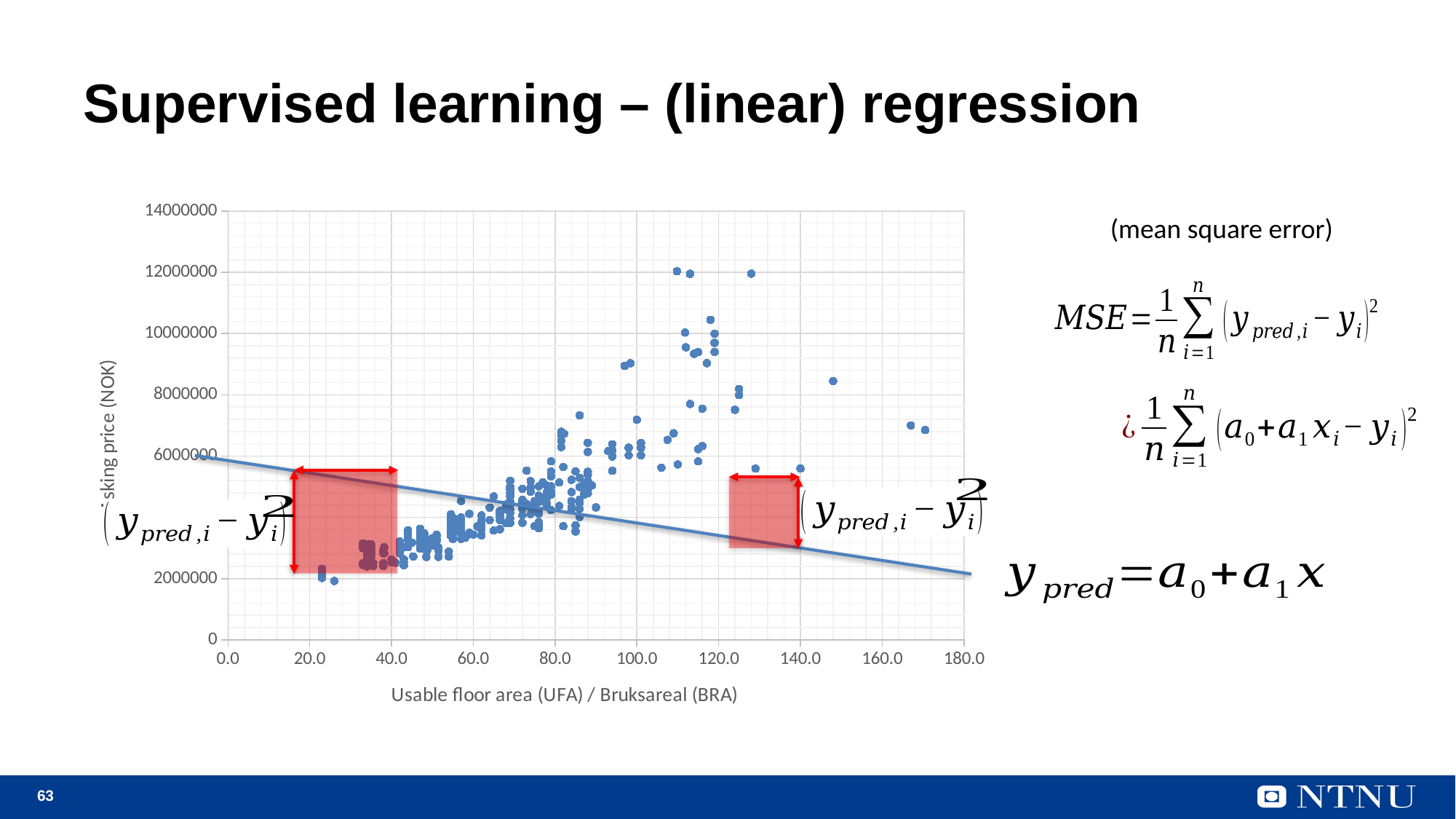
Does the fitted straight line in the chart rise or fall as usable floor area increases? Falls What is the title of the x axis of the chart? Usable floor area (UFA) / Bruksareal (BRA) How many labelled tick marks are there on the x axis of the chart? 10 What is the highest tick value shown on the y axis of the chart? 14000000 Is the value of the fitted line at a usable floor area of 0.0 greater or less than 4000000? greater What is the highest tick value shown on the x axis of the chart? 180.0 Is the value of the fitted line at a usable floor area of 180.0 greater or less than 4000000? less What kind of chart is shown on the slide? Scatter plot Do the plotted data points in the chart generally rise or fall as usable floor area increases? Rise What colour are the two highlighted squares drawn on the chart? Red Is the price of the highest data point in the chart greater or less than 10000000? greater